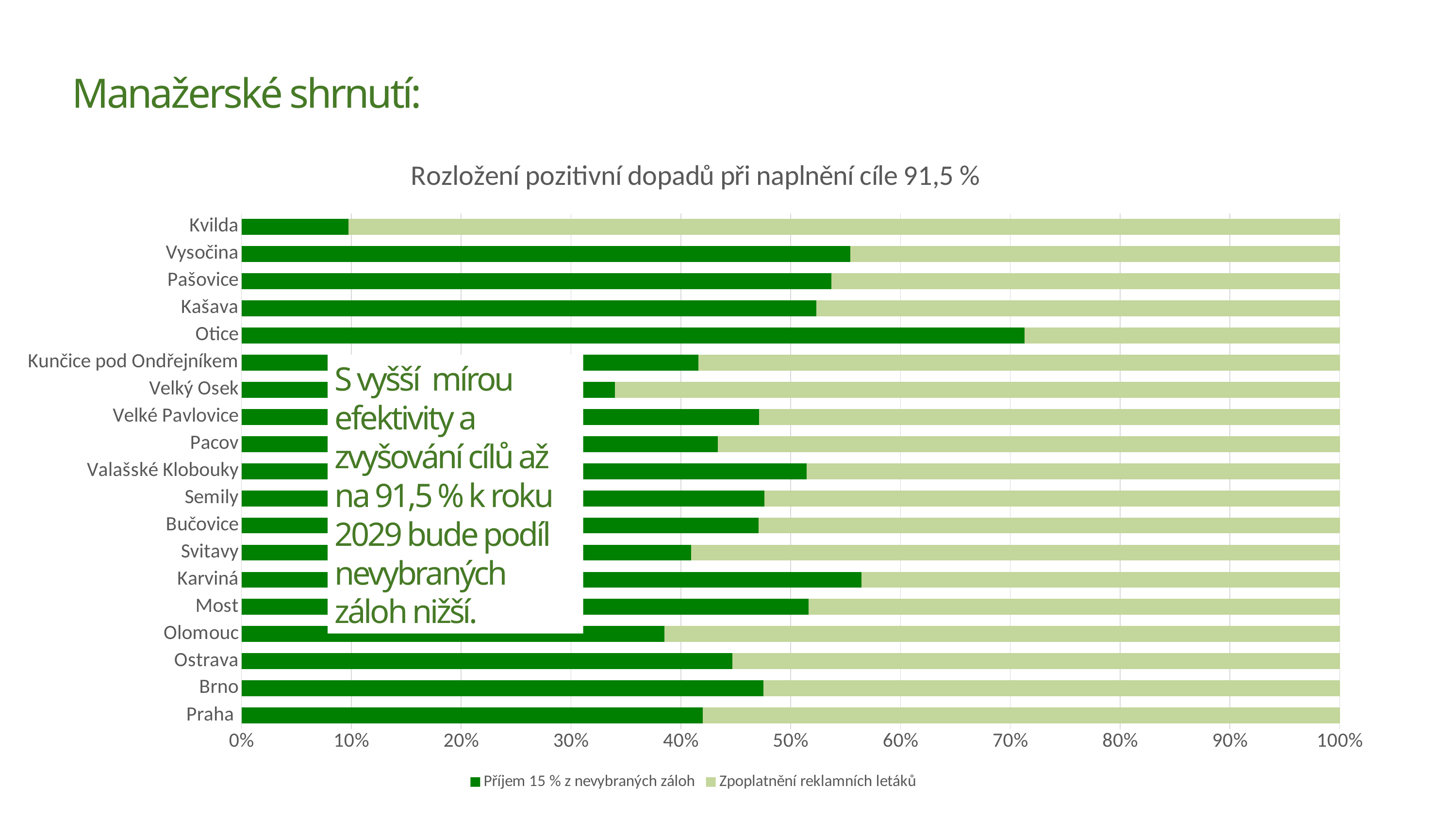
Which municipality has the largest share for 'Příjem 15 % z nevybraných záloh'? Otice Is the 'Příjem 15 % z nevybraných záloh' share for Kvilda greater or less than 20%? less Which municipality has the largest share for 'Zpoplatnění reklamních letáků'? Kvilda How many municipalities (categories) are shown on the chart? 19 Is the 'Příjem 15 % z nevybraných záloh' share for Velký Osek greater or less than 40%? less Is the 'Příjem 15 % z nevybraných záloh' share for Otice greater or less than 60%? greater How many series does the legend list? 2 Which series is shown in dark green in the legend? Příjem 15 % z nevybraných záloh Which has a larger 'Příjem 15 % z nevybraných záloh' share, Vysočina or Praha? Vysočina Which municipality has the smallest share for 'Příjem 15 % z nevybraných záloh'? Kvilda What kind of chart is shown on the slide? Stacked bar chart What is the title of the chart? Rozložení pozitivní dopadů při naplnění cíle 91,5 %